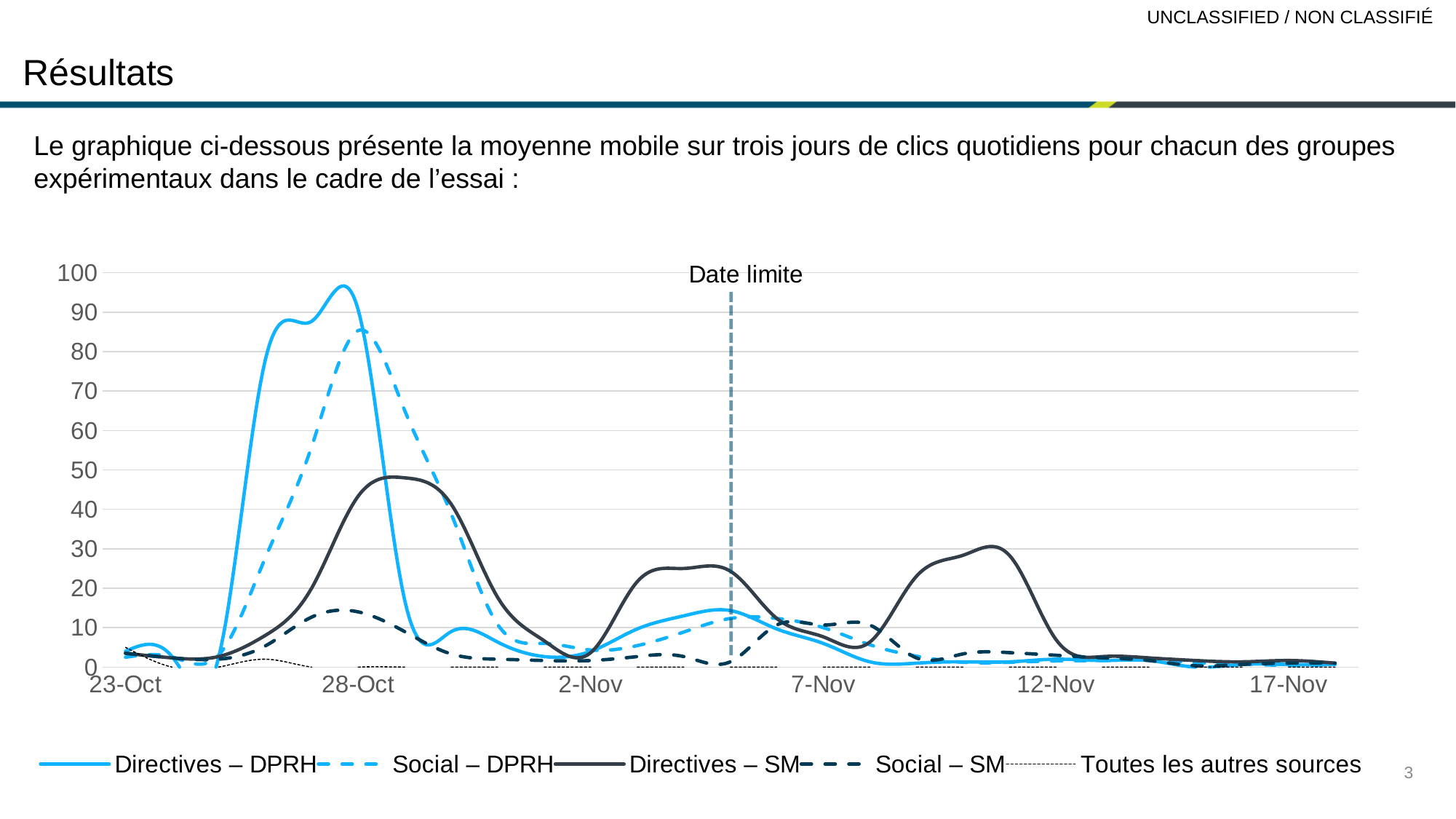
Is the peak value of Directives – DPRH greater or less than 90? greater What kind of chart is shown on the slide? line chart Is the peak value of Social – DPRH greater or less than 80? greater Which series reaches the highest value on the chart? Directives – DPRH Around 28-Oct, which is larger: Directives – DPRH or Directives – SM? Directives – DPRH Around 12-Nov, which is larger: Directives – SM or Directives – DPRH? Directives – SM Does the Directives – DPRH line rise or fall between 28-Oct and 2-Nov? fall Which series stays lowest across the whole chart? Toutes les autres sources Is the peak value of Directives – SM greater or less than 40? greater How many series does the legend list? 5 What label is attached to the vertical dashed line on the chart? Date limite